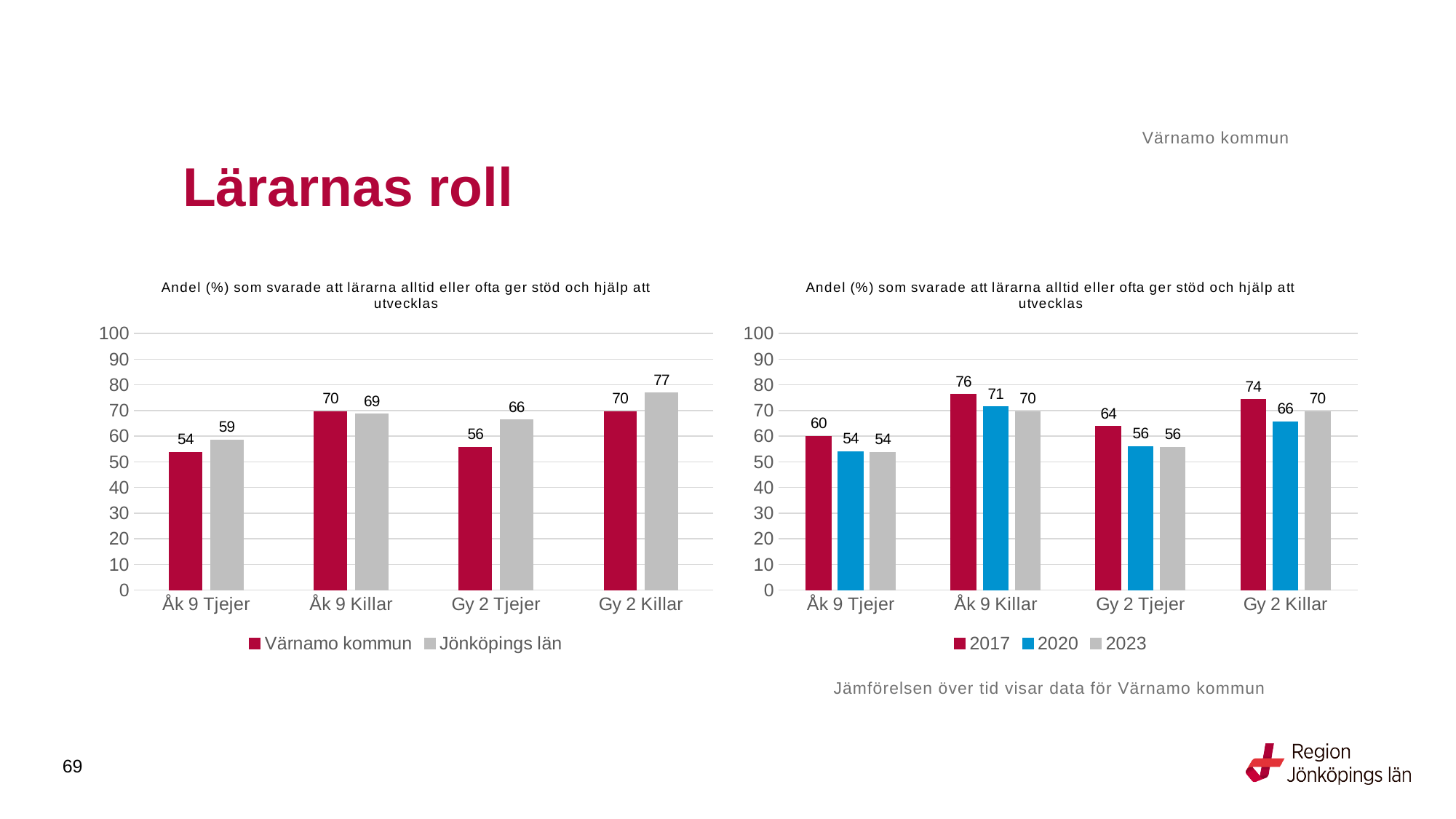
In the right chart, which category has the lowest value for 2017? Åk 9 Tjejer In the left chart, what is the value for Värnamo kommun for Åk 9 Tjejer? 54 In the right chart, what is the difference between the 2017 and 2023 values for Gy 2 Tjejer? 8 In the left chart, what is the value for Jönköpings län for Gy 2 Killar? 77 In the right chart, which is larger for Gy 2 Killar: the 2017 value or the 2020 value? 2017 In the right chart, what is the value for 2017 for Åk 9 Killar? 76 In the right chart, how many categories are shown on the x axis? 4 In the right chart, what is the value for 2023 for Gy 2 Tjejer? 56 In the left chart, how many series does the legend list? 2 What kind of chart is the right chart? Bar chart In the left chart, what is the difference between Jönköpings län and Värnamo kommun for Gy 2 Tjejer? 10 In the left chart, which category has the highest value for Jönköpings län? Gy 2 Killar